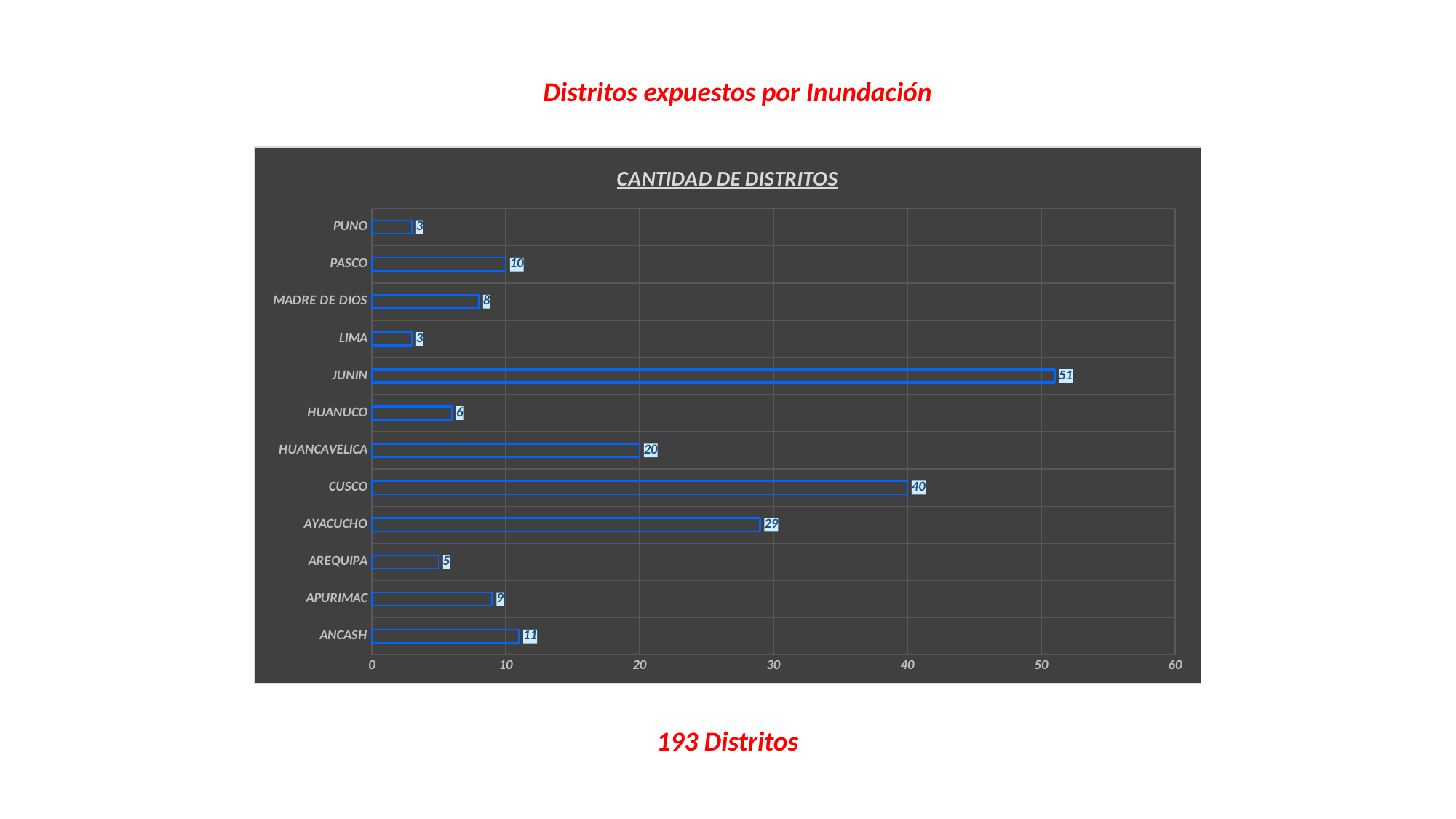
Which is larger, the value for PASCO or the value for APURIMAC? PASCO What kind of chart is shown? bar chart What is the difference between the values for JUNIN and HUANUCO? 45 How many regions are shown on the chart? 12 What is the title of the chart? CANTIDAD DE DISTRITOS What is the value for HUANCAVELICA? 20 Is the value for CUSCO greater or less than 30? greater What is the difference between the values for CUSCO and AYACUCHO? 11 What is the value for MADRE DE DIOS? 8 What is the value for ANCASH? 11 Which region has the highest number of districts? JUNIN What is the value for JUNIN? 51